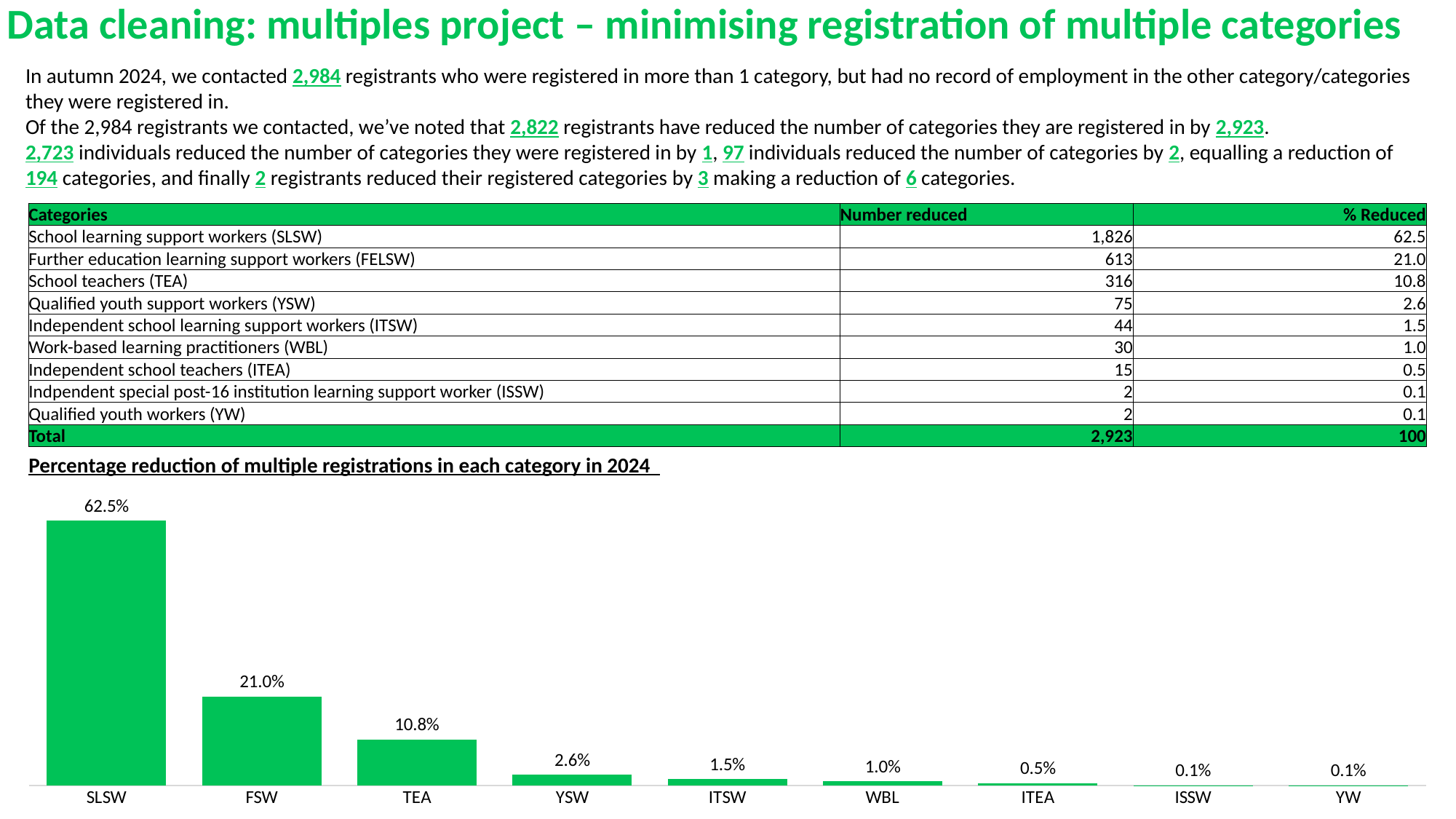
What is the difference between the values for SLSW and FSW in the chart? 41.5% What is the value shown for WBL in the chart? 1.0% Which is larger in the chart, the value for FSW or the value for TEA? FSW What is the difference between the values for TEA and YSW in the chart? 8.2% What is the value shown for ITSW in the chart? 1.5% What is the value shown for SLSW in the chart? 62.5% Which category has the highest percentage reduction in the chart? SLSW How many categories are plotted in the chart? 9 What kind of chart is shown on the slide? Bar chart What is the value shown for TEA in the chart? 10.8% Which is larger in the chart, the value for YSW or the value for ITEA? YSW What is the title of the chart? Percentage reduction of multiple registrations in each category in 2024